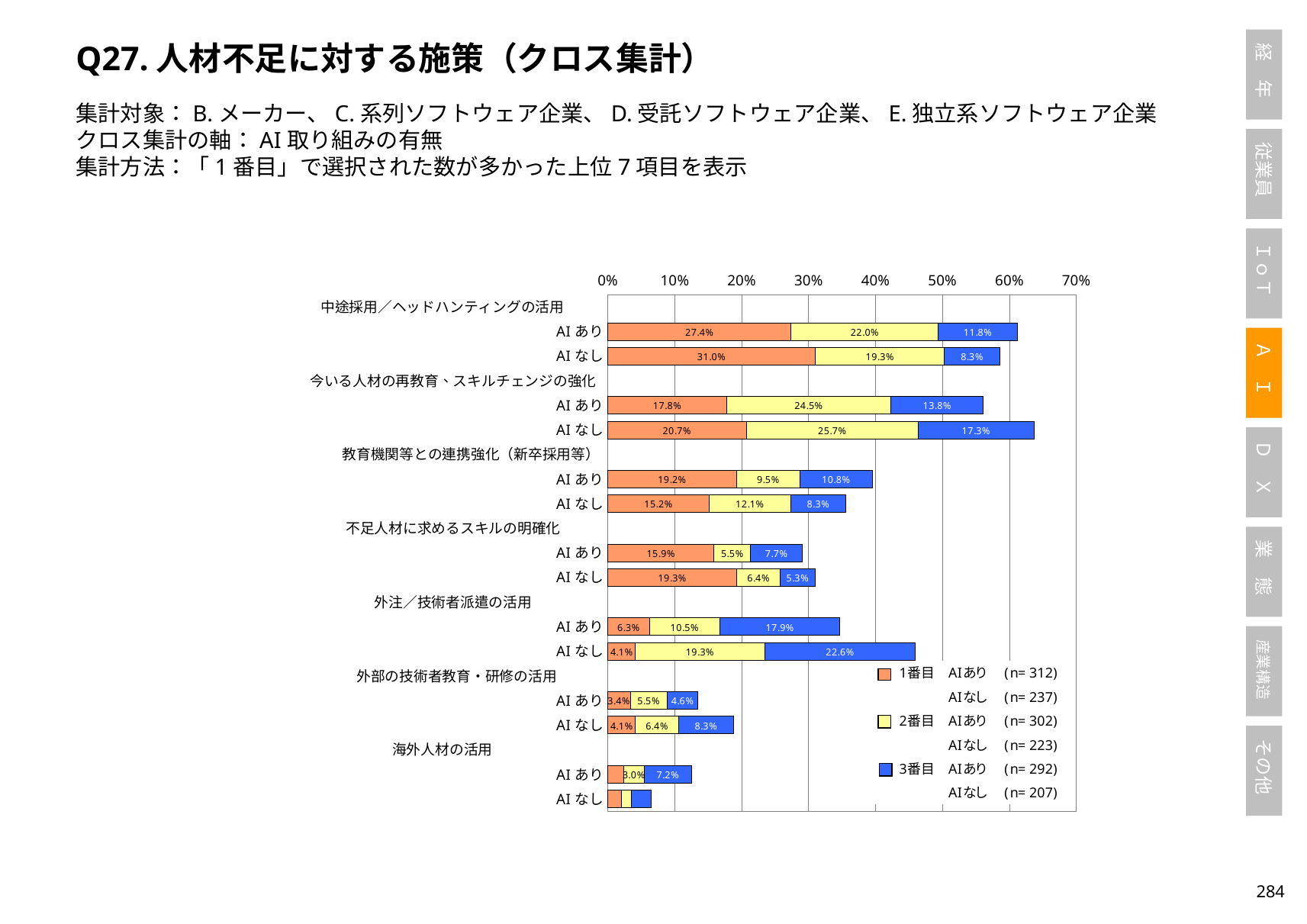
Which is larger: the 3番目 value for 外注／技術者派遣の活用 AI あり or AI なし? AI なし What is the n for 1番目 AIあり shown in the legend? 312 What kind of chart is shown on the slide? Stacked bar chart What is the difference between the 1番目 values for 中途採用／ヘッドハンティングの活用 AI なし (31.0%) and AI あり (27.4%)? 3.6% How many measure categories (施策) are shown on the chart? 7 What is the total of the stacked bar for 中途採用／ヘッドハンティングの活用, AI あり? 61.2% How many series does the legend list? 3 Is the total stacked bar for 今いる人材の再教育、スキルチェンジの強化, AI なし greater or less than 60%? greater Which AI あり bar has the highest 1番目 value? 中途採用／ヘッドハンティングの活用 What is the 3番目 value for 外注／技術者派遣の活用, AI なし? 22.6% What is the 1番目 value for 中途採用／ヘッドハンティングの活用, AI あり? 27.4% What is the 2番目 value for 今いる人材の再教育、スキルチェンジの強化, AI なし? 25.7%